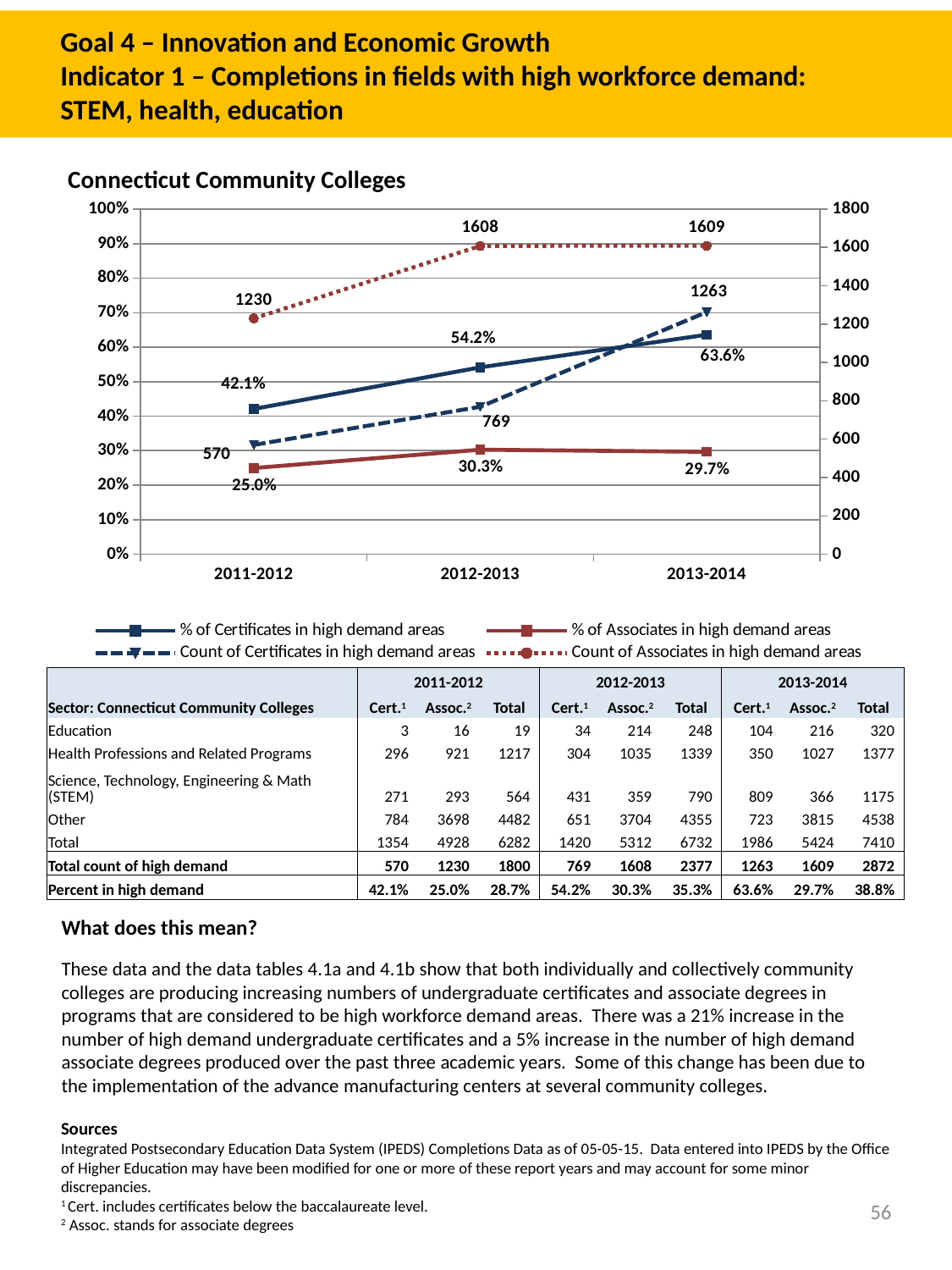
What kind of chart is shown under the heading "Connecticut Community Colleges"? Line chart How many academic years are plotted along the x axis of the chart? 3 How many series does the chart legend list? 4 In which academic year is "% of Associates in high demand areas" lowest? 2011-2012 Which series in the chart is drawn with a dotted line? Count of Associates in high demand areas In which academic year is "Count of Certificates in high demand areas" highest? 2013-2014 What is the value for "% of Associates in high demand areas" in 2013-2014? 29.7% What is the value for "Count of Associates in high demand areas" in 2011-2012? 1230 Does "% of Certificates in high demand areas" rise or fall from 2011-2012 to 2013-2014? Rise Which is larger in 2012-2013: the Count of Associates in high demand areas or the Count of Certificates in high demand areas? Count of Associates in high demand areas What is the value for "% of Certificates in high demand areas" in 2012-2013? 54.2% What is the difference between the Count of Certificates in high demand areas in 2013-2014 and in 2011-2012? 693